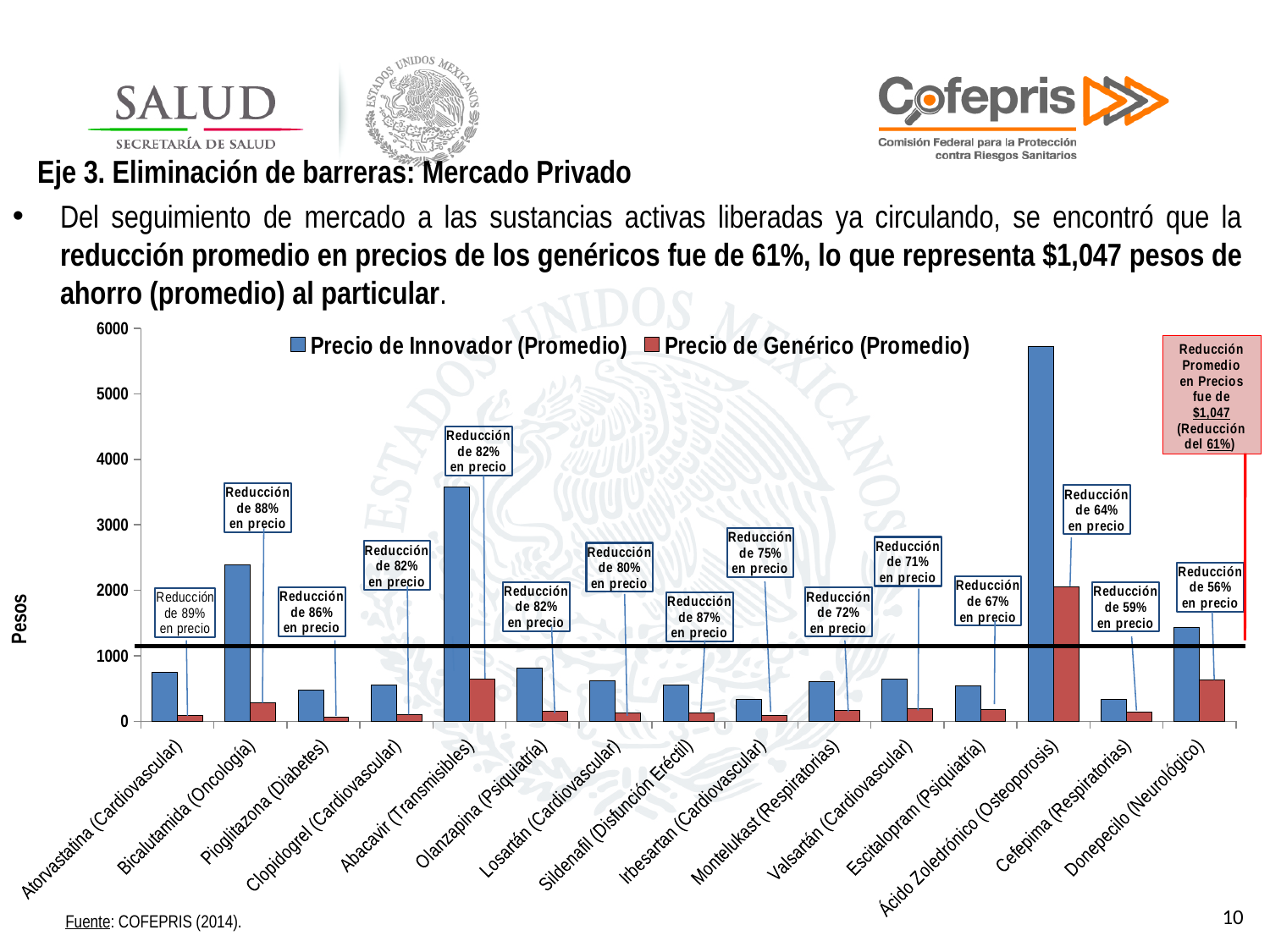
Which medicine has the highest Precio de Genérico (Promedio)? Ácido Zoledrónico (Osteoporosis) Which medicine has the highest Precio de Innovador (Promedio)? Ácido Zoledrónico (Osteoporosis) Is the Precio de Innovador (Promedio) for Abacavir (Transmisibles) greater or less than 3000? greater Which is larger, the Precio de Innovador (Promedio) for Abacavir (Transmisibles) or for Bicalutamida (Oncología)? Abacavir (Transmisibles) How many medicines (categories) are shown on the x axis of the chart? 15 Is the Precio de Innovador (Promedio) for Ácido Zoledrónico (Osteoporosis) greater or less than 5000? greater According to the annotation on the chart, what is the price reduction for Atorvastatina (Cardiovascular)? 89% What is the label of the y axis of the chart? Pesos How many series does the chart legend list? 2 According to the annotation on the chart, what is the price reduction for Donepecilo (Neurológico)? 56% Is the Precio de Innovador (Promedio) for Atorvastatina (Cardiovascular) greater or less than 1000? less What kind of chart is shown on the slide? bar chart